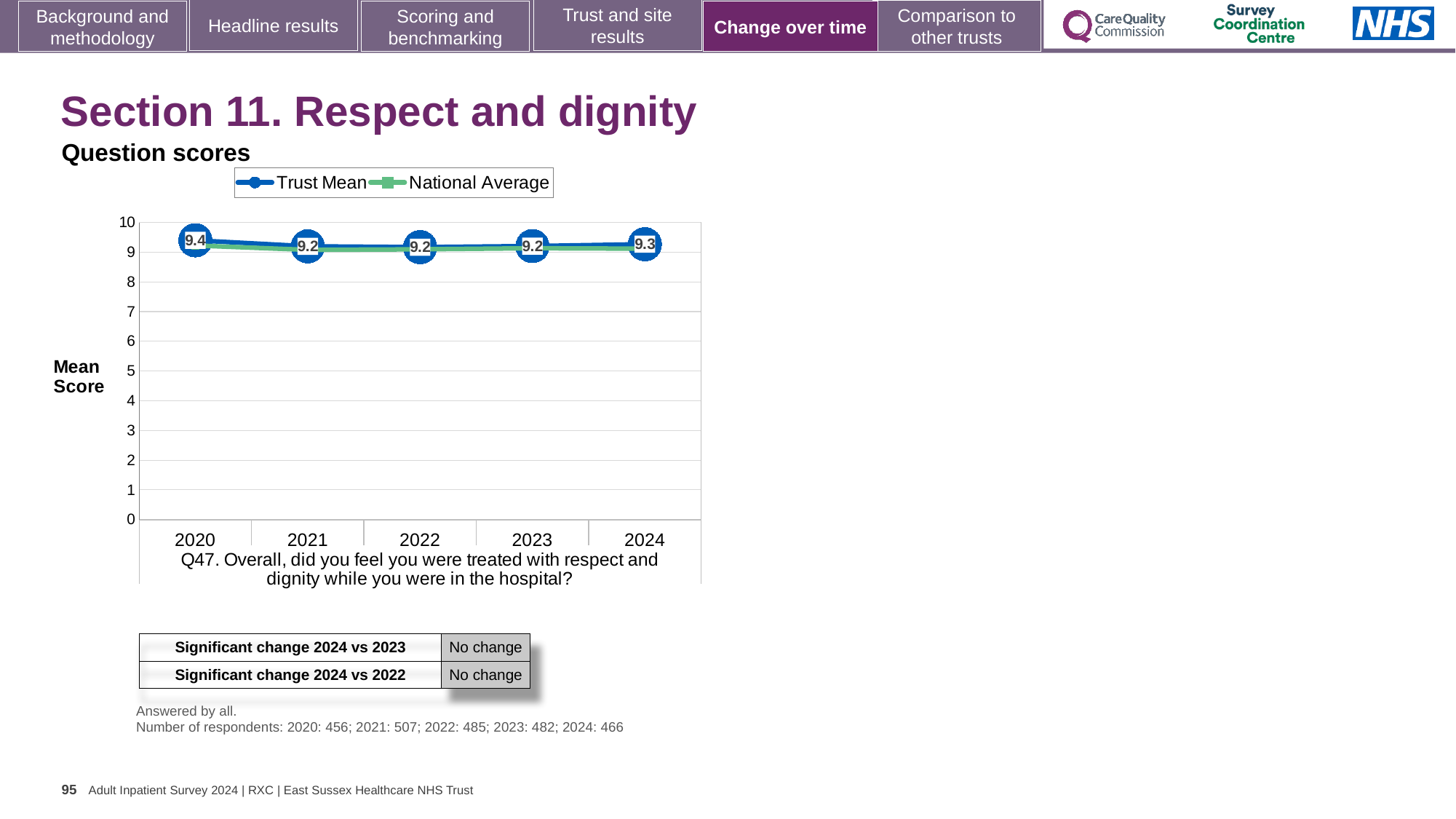
How many years are plotted on the x axis? 5 What is the label of the y axis? Mean Score Which year has the larger Trust Mean score, 2020 or 2021? 2020 In which year is the Trust Mean score highest? 2020 Does the Trust Mean score rise or fall from 2020 to 2021? fall How many series does the legend list? 2 What is the Trust Mean score for 2024? 9.3 What is the Trust Mean score for 2020? 9.4 What kind of chart is shown? line chart What is the difference between the Trust Mean scores for 2020 and 2024? 0.1 Is the National Average value for 2022 greater or less than 5? greater What is the Trust Mean score for 2022? 9.2